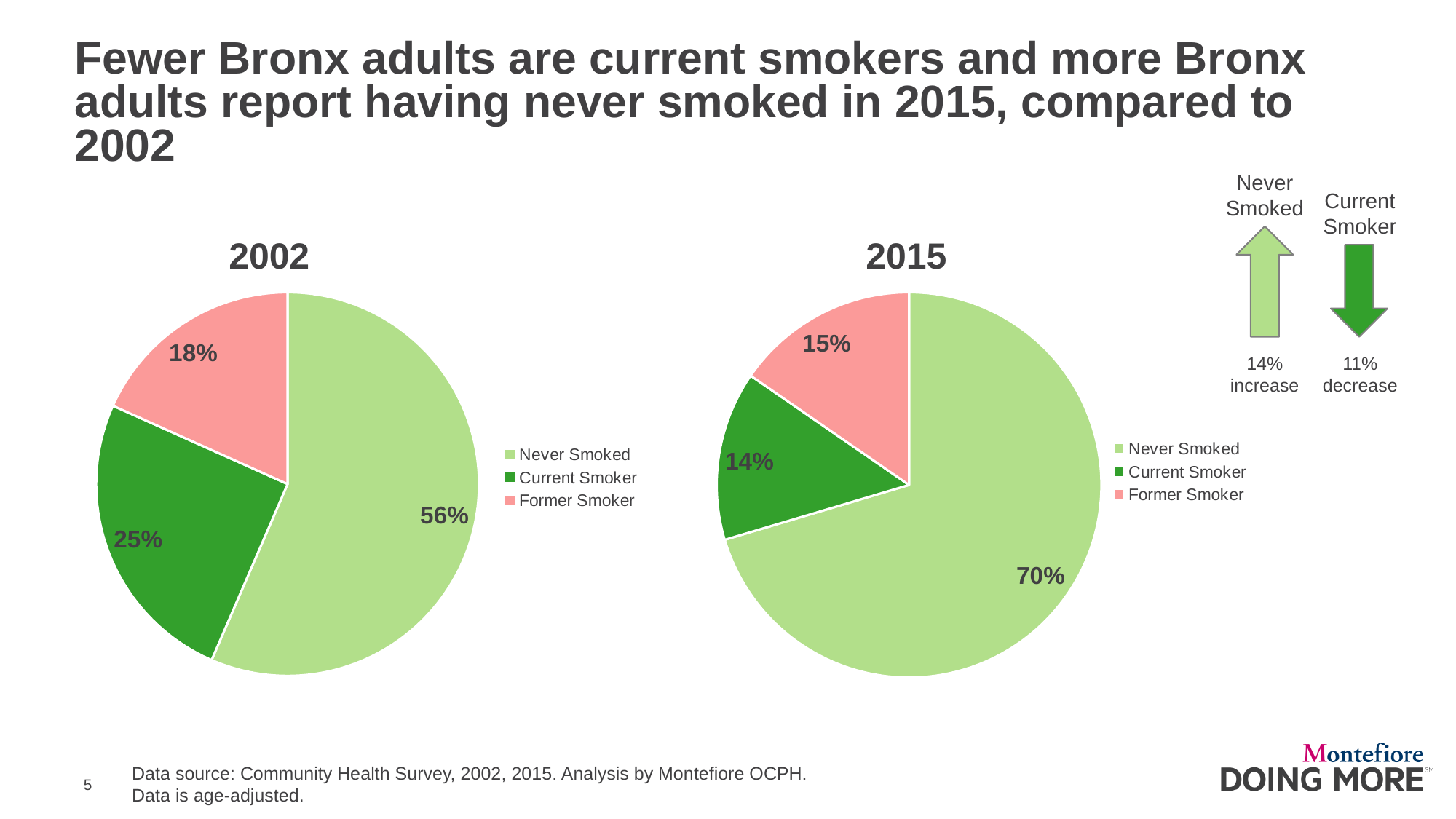
In the 2002 pie chart, what is the value for Former Smoker? 18% In the 2002 pie chart, which category has the largest slice? Never Smoked Which is larger: the Current Smoker share in 2002 or the Current Smoker share in 2015? 2002 In the 2002 pie chart, what share of Bronx adults were Current Smokers? 25% What is the difference between the Never Smoked share in 2015 and in 2002? 14% In the 2015 pie chart, what is the value for Current Smoker? 14% How many entries does the legend of the 2002 chart list? 3 In the 2015 pie chart, which category has the smallest slice? Current Smoker How many slices does the 2015 pie chart have? 3 In the 2002 pie chart, what is the difference between the Current Smoker and Former Smoker shares? 7% In the 2015 pie chart, what share of Bronx adults reported having Never Smoked? 70% What type of chart is used to show the 2002 data? Pie chart